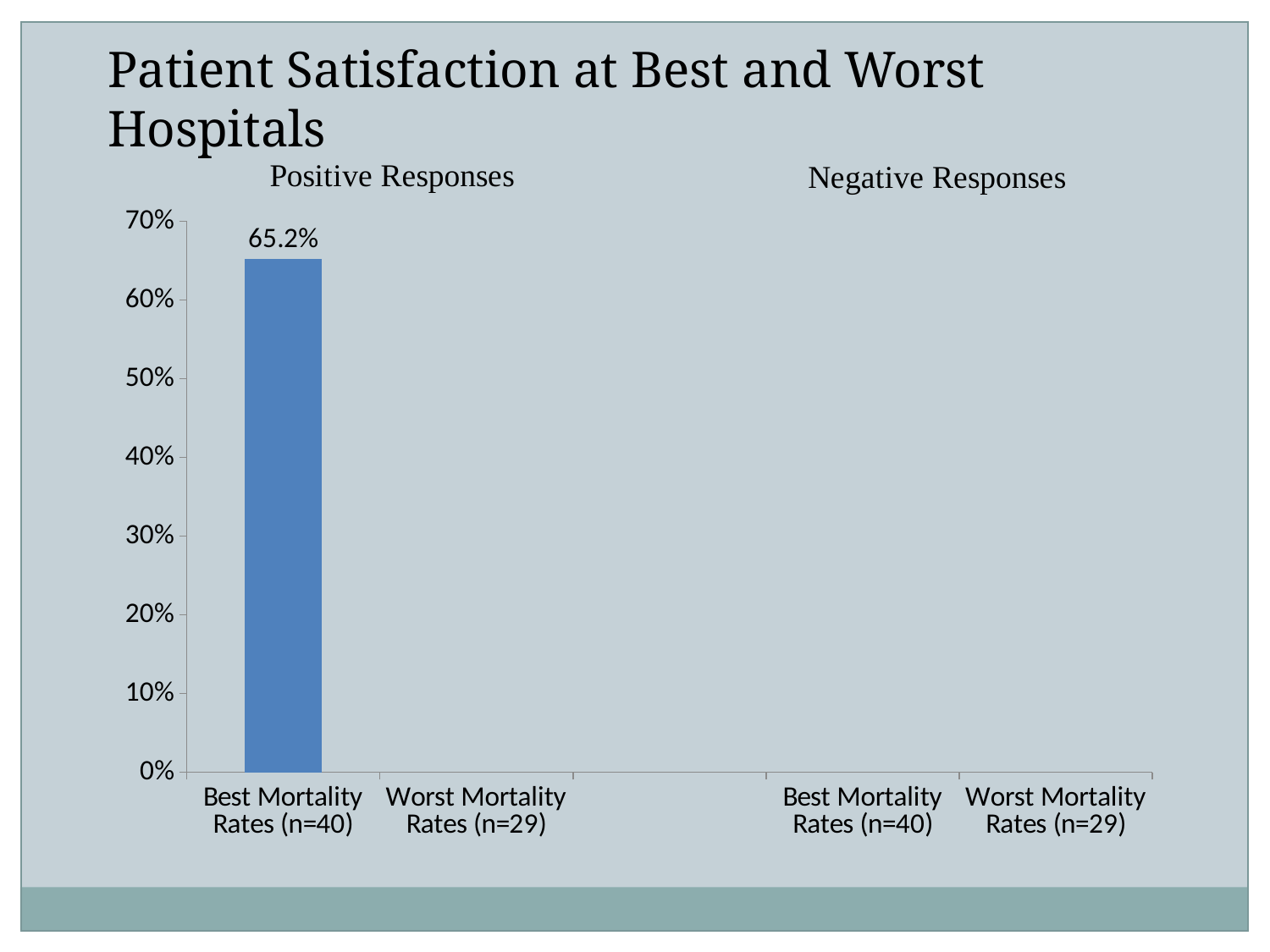
How many bars are plotted on the chart? 1 What is the value for Best Mortality Rates (n=40) under Positive Responses? 65.2% What kind of chart is shown on the slide? bar chart Is the value for Best Mortality Rates (n=40) under Positive Responses greater or less than 60%? greater What are the two group headings shown above the chart? Positive Responses and Negative Responses Is the value for Best Mortality Rates (n=40) under Positive Responses greater or less than 70%? less What is the title of the slide? Patient Satisfaction at Best and Worst Hospitals How many category labels appear along the x axis? 4